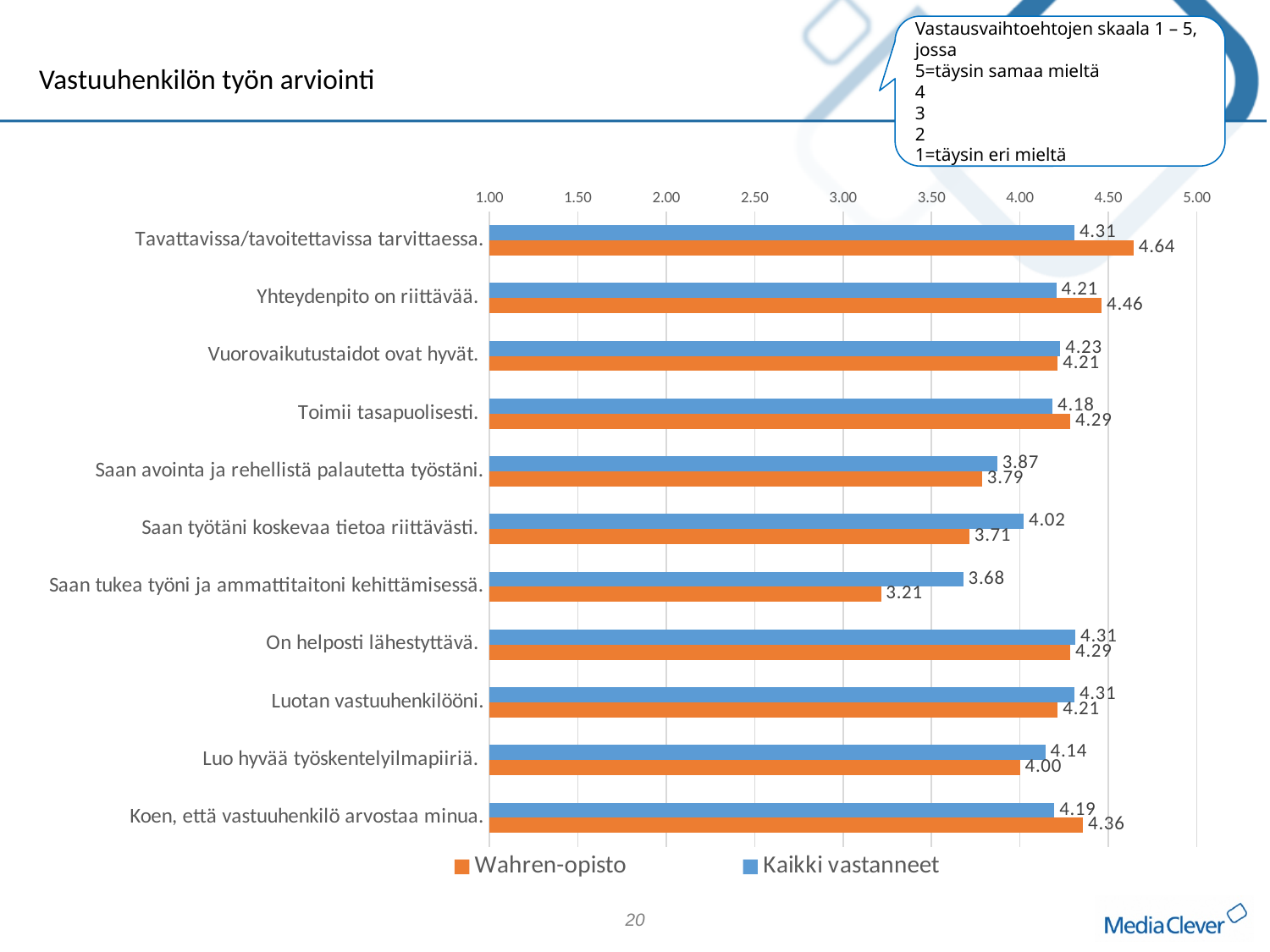
What is the Wahren-opisto value for "Tavattavissa/tavoitettavissa tarvittaessa."? 4.64 Which statement has the lowest Wahren-opisto value? Saan tukea työni ja ammattitaitoni kehittämisessä. What kind of chart is shown on the slide? bar chart Which statement has the lowest Kaikki vastanneet value? Saan tukea työni ja ammattitaitoni kehittämisessä. How many series does the legend list? 2 What is the Wahren-opisto value for "Luo hyvää työskentelyilmapiiriä."? 4.00 What is the Kaikki vastanneet value for "Saan tukea työni ja ammattitaitoni kehittämisessä."? 3.68 What is the difference between the Kaikki vastanneet and Wahren-opisto values for "Saan tukea työni ja ammattitaitoni kehittämisessä."? 0.47 Which series is shown in orange in the chart? Wahren-opisto For "Saan työtäni koskevaa tietoa riittävästi.", which series has the larger value, Wahren-opisto or Kaikki vastanneet? Kaikki vastanneet Which statement has the highest Wahren-opisto value? Tavattavissa/tavoitettavissa tarvittaessa. How many categories (statements) are plotted in the chart? 11